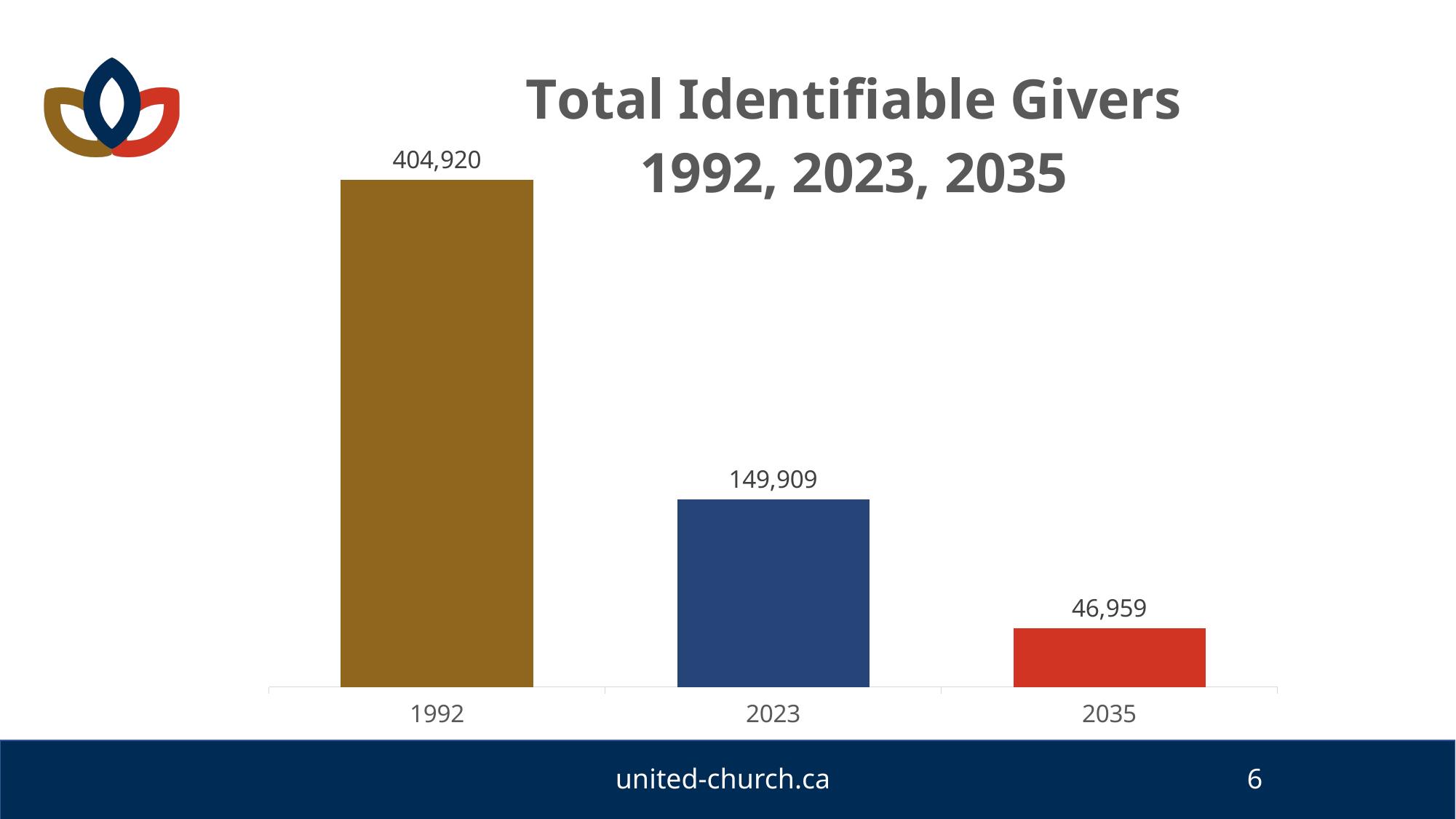
What is the value for 2035? 46,959 Which is larger, the value for 2023 or the value for 2035? 2023 Do the values rise or fall from 1992 to 2035? fall What is the difference between the values for 2023 and 2035? 102,950 What kind of chart is shown on the slide? bar chart What is the value for 2023? 149,909 What is the difference between the values for 1992 and 2023? 255,011 What is the value for 1992? 404,920 Which year has the lowest number of identifiable givers? 2035 What is the title of the chart? Total Identifiable Givers 1992, 2023, 2035 Which year has the highest number of identifiable givers? 1992 How many years are shown on the chart? 3